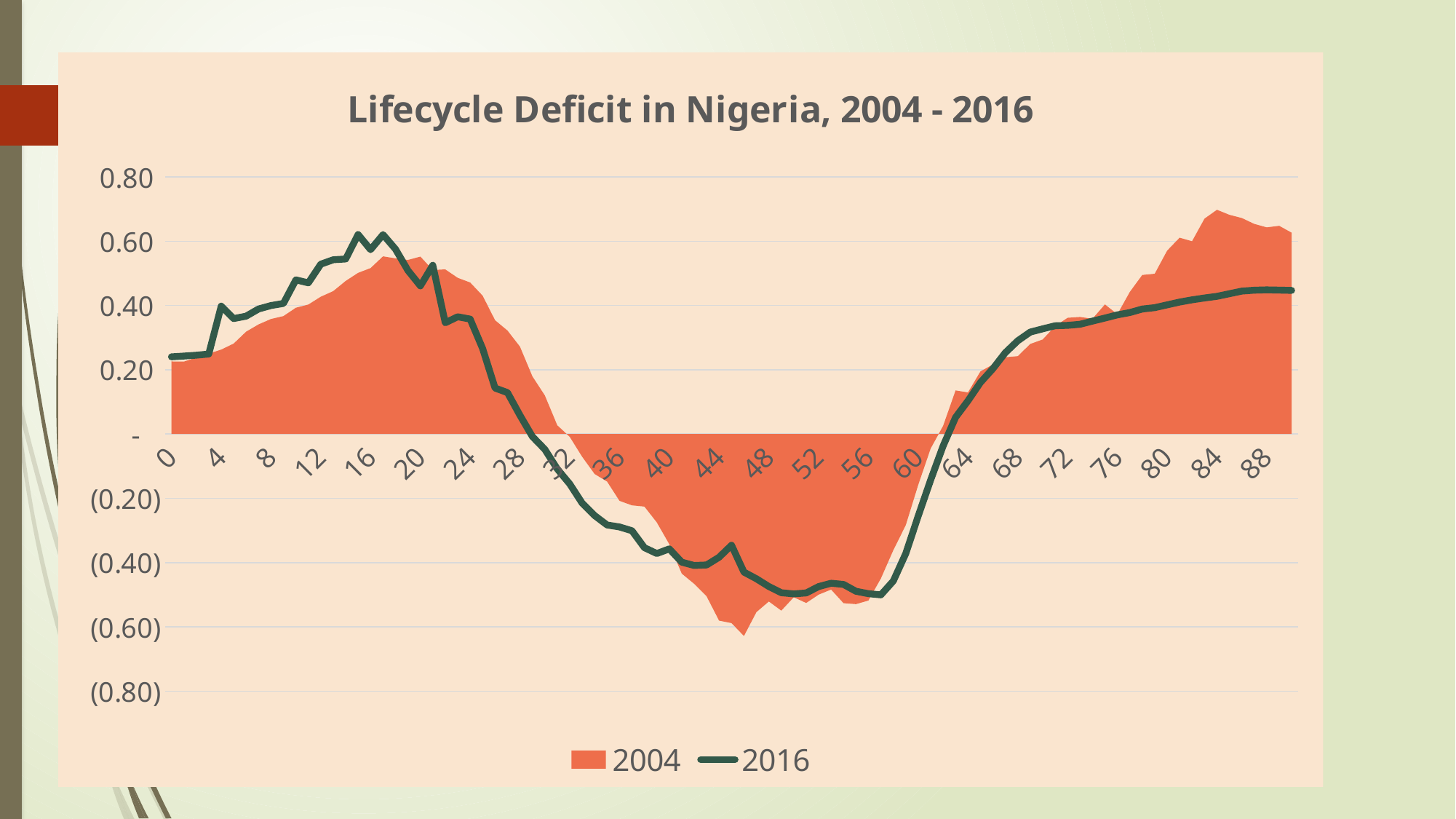
What kind of chart is this? A combination chart: a filled area series (2004) and a line series (2016) Is the 2004 value at age 20 greater or less than 0.40? greater Is the 2016 value at age 48 greater or less than -0.40? less Is the 2016 value at age 0 greater or less than 0.20? greater How many series does the legend list? 2 Which two series are shown in the legend? 2004 and 2016 At age 4, which series has the larger value, 2004 or 2016? 2016 At age 84, which series has the larger value, 2004 or 2016? 2004 What is the title of the chart? Lifecycle Deficit in Nigeria, 2004 - 2016 Does the 2016 line rise or fall between age 20 and age 48? fall